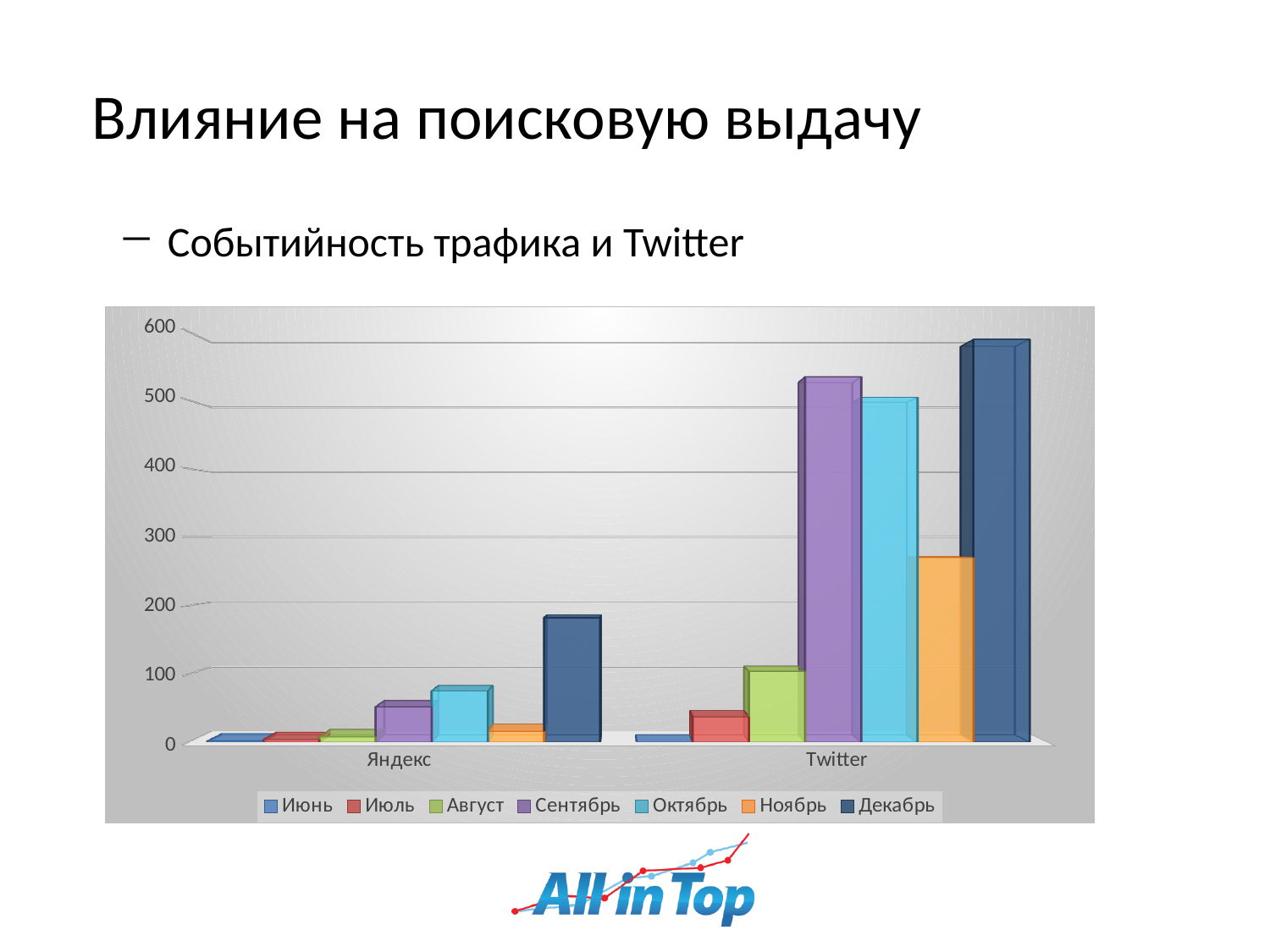
Which is larger: the Ноябрь bar for Twitter or the Декабрь bar for Яндекс? Ноябрь bar for Twitter Which month has the highest bar for Яндекс? Декабрь Is the value for Октябрь in the Яндекс category greater or less than 100? less Is the value for Декабрь in the Яндекс category greater or less than 200? less What are the two category labels on the x axis of the chart? Яндекс and Twitter Is the value for Ноябрь in the Twitter category greater or less than 300? less What kind of chart is shown on the slide? bar chart Which is larger for Twitter: the Декабрь bar or the Сентябрь bar? Декабрь How many series does the chart legend list? 7 How many categories are shown on the x axis of the chart? 2 Which month has the highest bar for Twitter? Декабрь